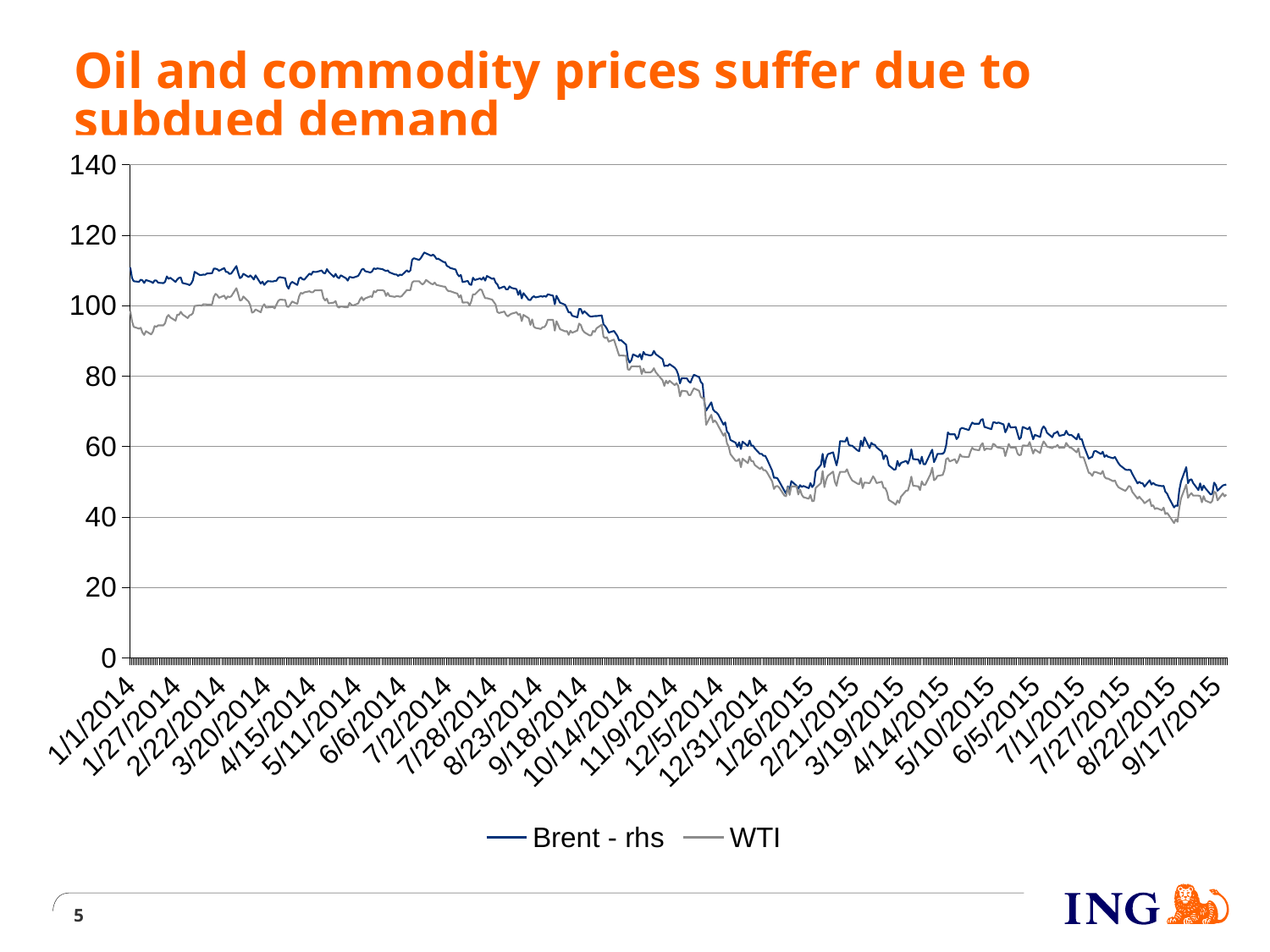
What kind of chart is shown on the slide? line chart At 1/1/2014, which series has the higher value, Brent - rhs or WTI? Brent - rhs What are the two series named in the legend? Brent - rhs and WTI Do the Brent - rhs values generally rise or fall from 1/1/2014 to 9/17/2015? fall Is the value for WTI at 7/2/2014 greater or less than 80? greater Is the value for Brent - rhs at 12/31/2014 greater or less than 80? less What is the title of the slide containing the chart? Oil and commodity prices suffer due to subdued demand What is the highest value shown on the vertical axis? 140 How many series does the legend list? 2 Is the value for WTI at 9/17/2015 greater or less than 60? less